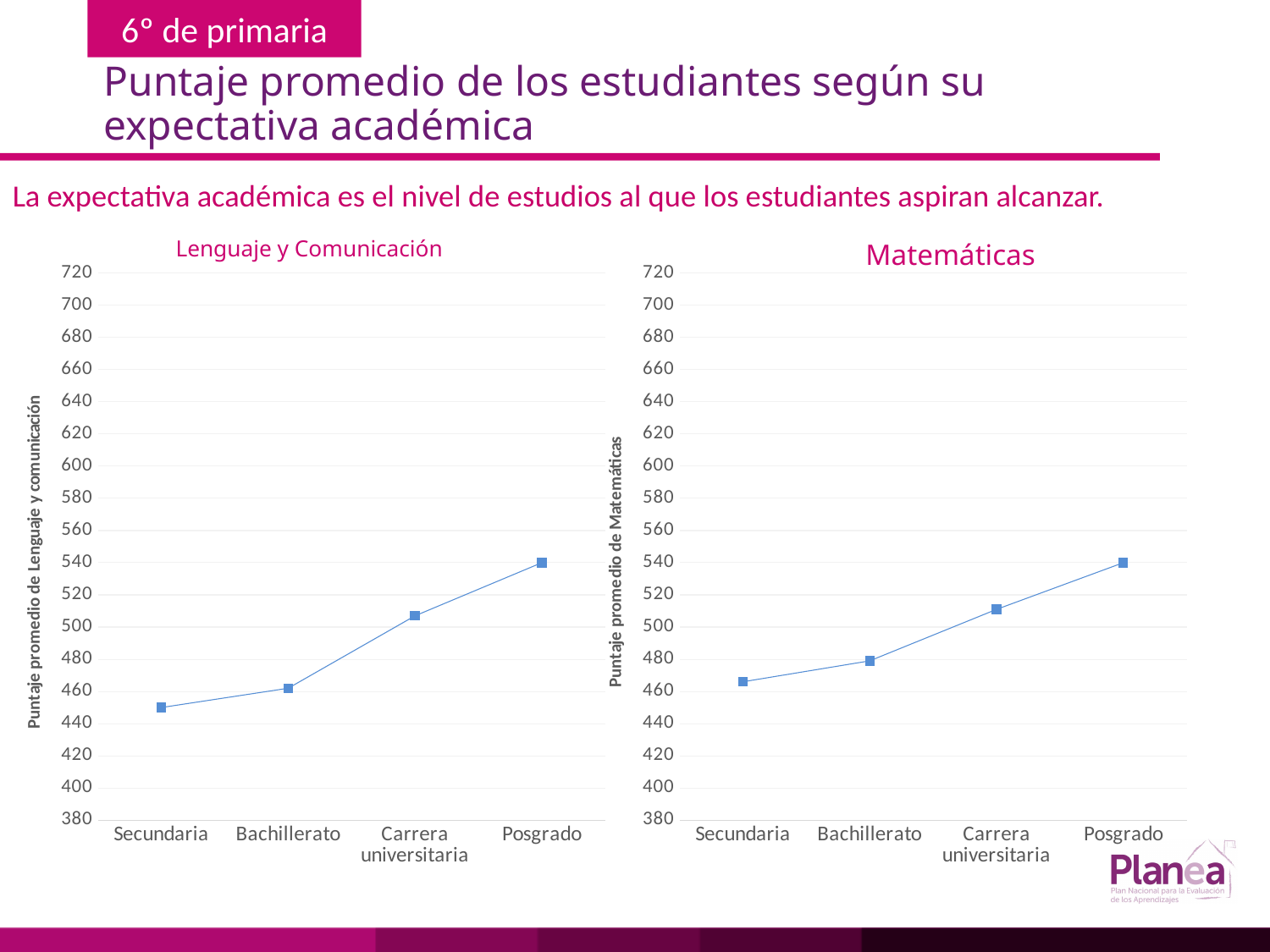
In the Matemáticas chart, which is larger, the value for Carrera universitaria or the value for Bachillerato? Carrera universitaria In the Lenguaje y Comunicación chart, which category has the lowest score? Secundaria In the Matemáticas chart, is the value for Bachillerato greater or less than 500? less In the Matemáticas chart, which category has the lowest score? Secundaria In the Lenguaje y Comunicación chart, is the value for Carrera universitaria greater or less than 500? greater In the Matemáticas chart, which category has the highest score? Posgrado How many categories are shown on the x axis of the Lenguaje y Comunicación chart? 4 In the Matemáticas chart, is the value for Secundaria greater or less than 460? greater In the Matemáticas chart, do the values rise or fall from Secundaria to Posgrado? rise What kind of chart is the Lenguaje y Comunicación chart? line chart In the Lenguaje y Comunicación chart, which category has the highest score? Posgrado